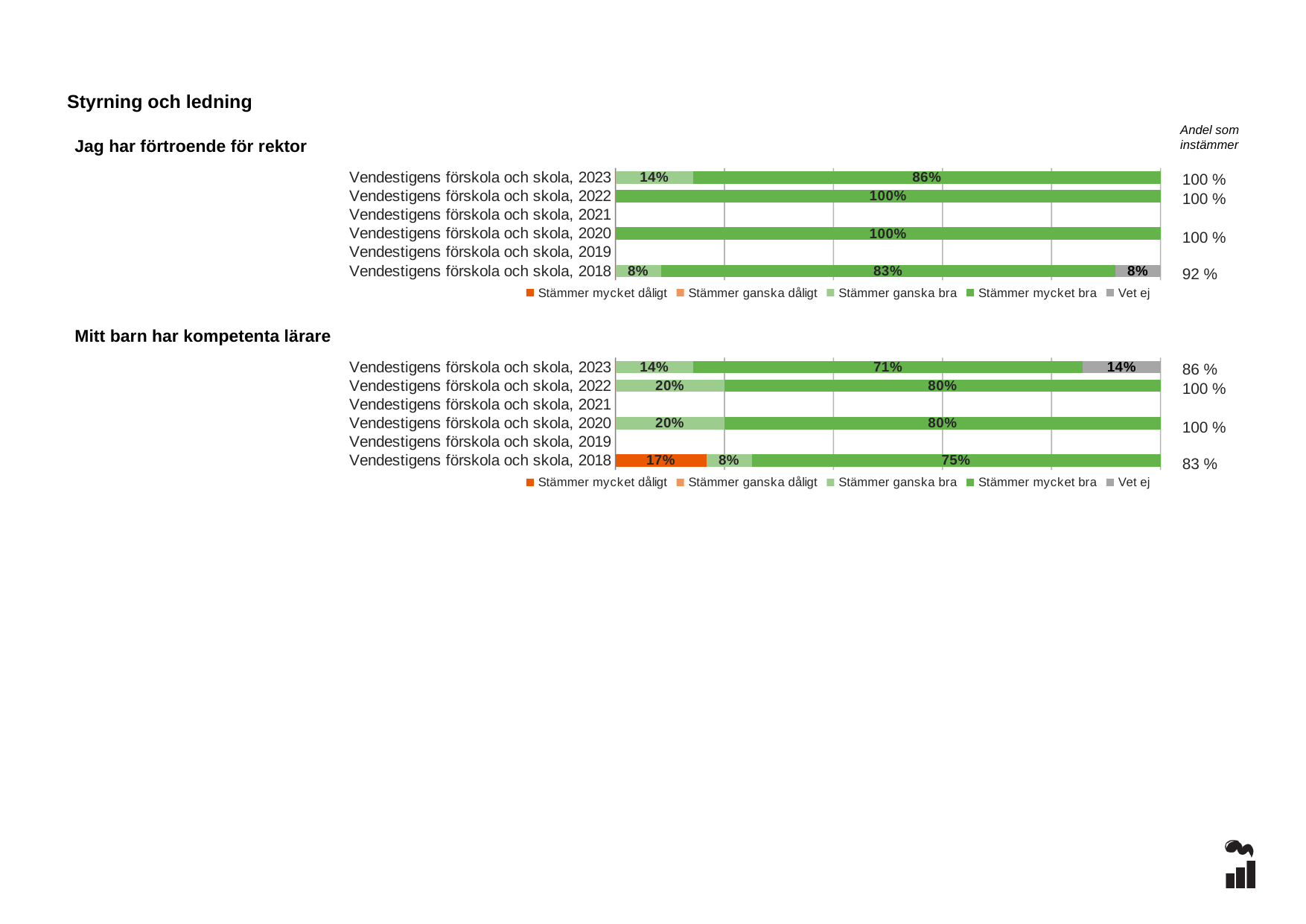
In the chart "Mitt barn har kompetenta lärare", what is the difference between the "Stämmer mycket bra" values for 2022 and 2023? 9% In the chart "Mitt barn har kompetenta lärare", which year has the lowest "Stämmer mycket bra" value? Vendestigens förskola och skola, 2023 What kind of chart is "Jag har förtroende för rektor"? Stacked bar chart How many category rows are listed on the y axis of the chart "Mitt barn har kompetenta lärare"? 6 How many series does the legend of the chart "Jag har förtroende för rektor" list? 5 In the chart "Jag har förtroende för rektor", which is larger: the "Stämmer ganska bra" value for 2023 or for 2018? 2023 In the chart "Jag har förtroende för rektor", what is the "Stämmer mycket bra" value for Vendestigens förskola och skola, 2023? 86% In the chart "Mitt barn har kompetenta lärare", what is the "Stämmer ganska bra" value for Vendestigens förskola och skola, 2022? 20% In the chart "Jag har förtroende för rektor", what is the "Andel som instämmer" shown for Vendestigens förskola och skola, 2018? 92 % In the chart "Jag har förtroende för rektor", what is the "Vet ej" value for Vendestigens förskola och skola, 2018? 8% In the chart "Mitt barn har kompetenta lärare", what is the "Stämmer mycket dåligt" value for Vendestigens förskola och skola, 2018? 17% In the chart "Mitt barn har kompetenta lärare", what is the "Andel som instämmer" shown for Vendestigens förskola och skola, 2023? 86 %